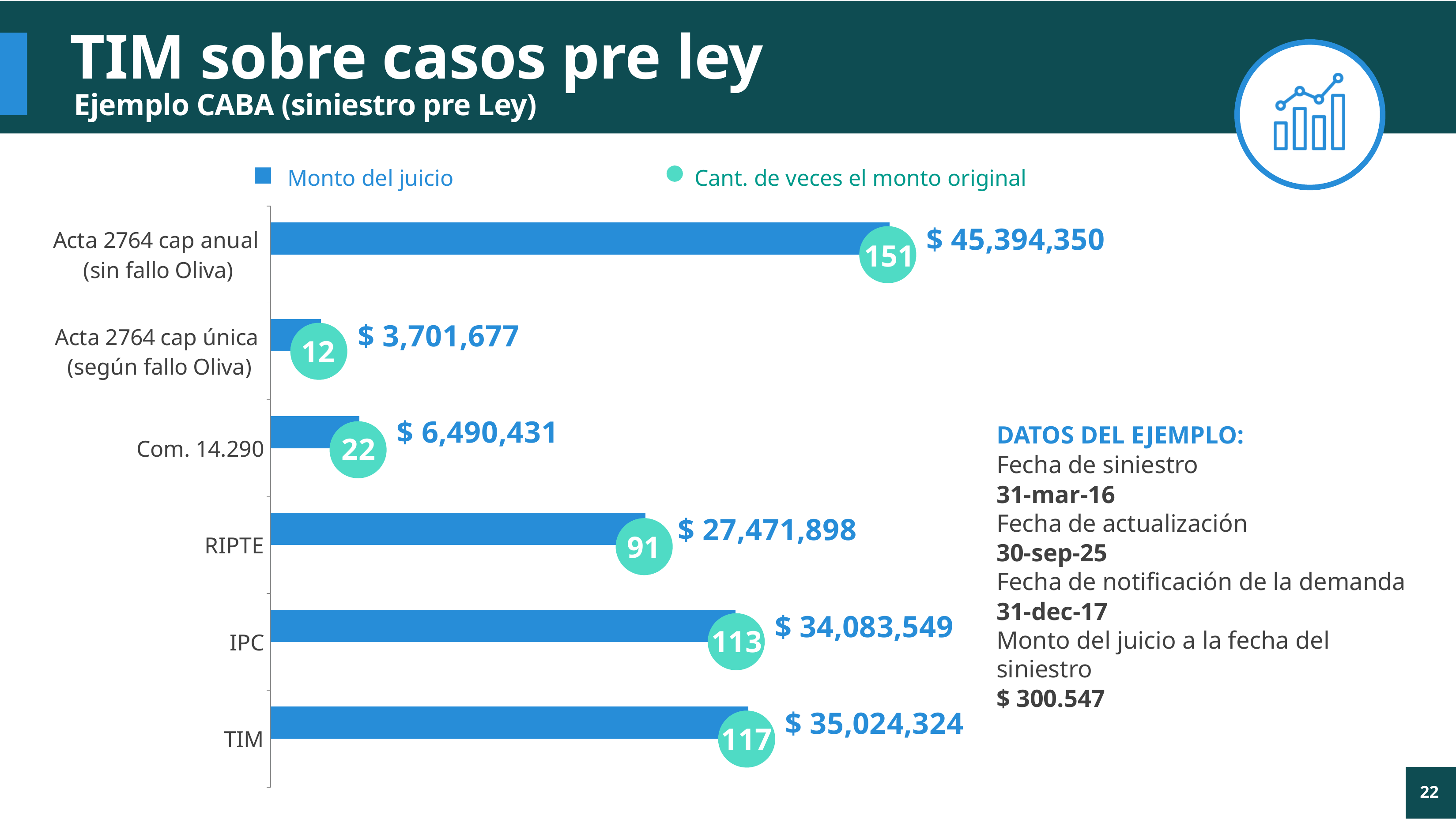
Which category has the lowest Monto del juicio? Acta 2764 cap única (según fallo Oliva) What is the Monto del juicio for Acta 2764 cap única (según fallo Oliva)? $ 3,701,677 What kind of chart is shown on the slide? Bar chart How many series does the legend list? 2 Which category has the highest Monto del juicio? Acta 2764 cap anual (sin fallo Oliva) What is the difference in Monto del juicio between TIM and IPC? $ 940,775 How many categories are shown in the chart? 6 What is the Cant. de veces el monto original for IPC? 113 Which has a larger Monto del juicio, RIPTE or IPC? IPC What is the Monto del juicio for RIPTE? $ 27,471,898 What is the difference in Cant. de veces el monto original between Acta 2764 cap anual (sin fallo Oliva) and TIM? 34 What is the Cant. de veces el monto original for Com. 14.290? 22